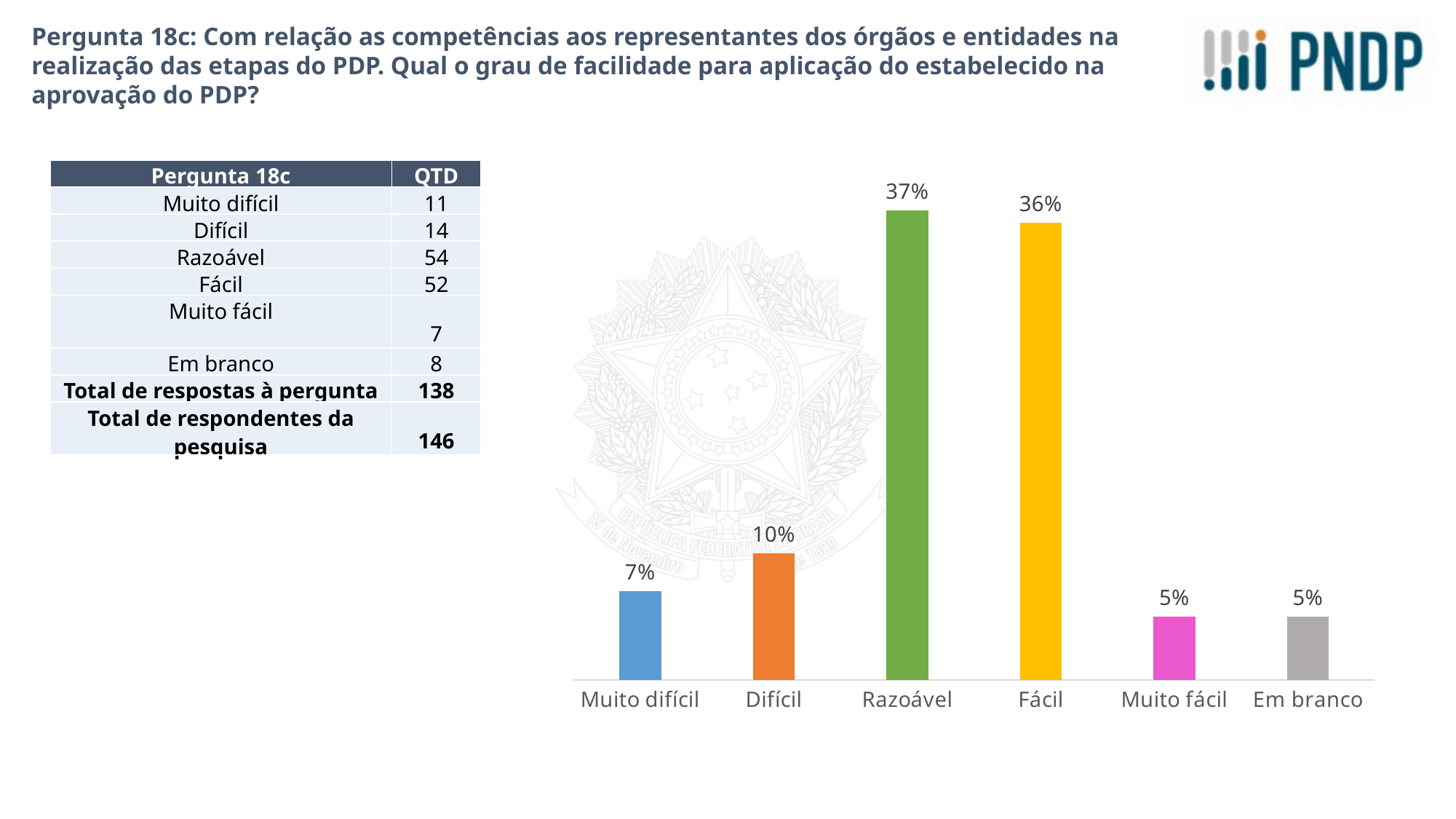
Which category has the highest value in the bar chart? Razoável What percentage is shown for Fácil in the bar chart? 36% What colour is the bar for Fácil? Yellow What percentage is shown for Difícil in the bar chart? 10% What is the difference in percentage points between Razoável and Fácil? 1% Which is larger, the value for Difícil or the value for Muito fácil? Difícil What percentage is shown for Em branco in the bar chart? 5% What percentage is shown for Muito difícil in the bar chart? 7% What is the difference in percentage points between Difícil and Muito difícil? 3% What percentage is shown for Razoável in the bar chart? 37% How many categories are shown on the x axis of the bar chart? 6 What type of chart is shown on the slide? Bar chart